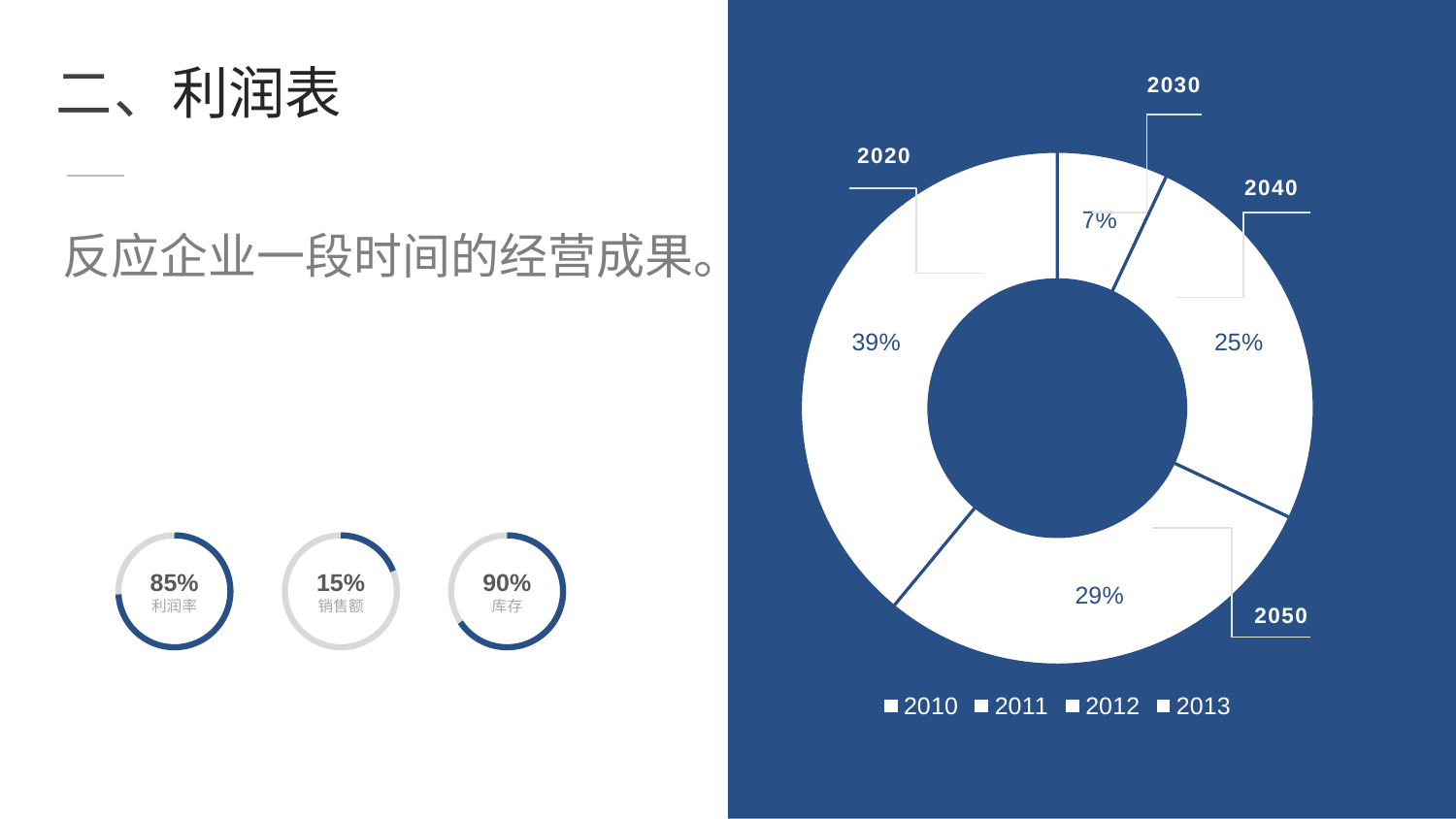
What is the title of the slide containing the doughnut chart? 二、利润表 What is the smallest percentage shown on the doughnut chart? 7% What are the four percentage labels shown on the doughnut chart? 7%, 25%, 29%, 39% How many slices does the doughnut chart have? 4 What are the legend entries of the doughnut chart? 2010, 2011, 2012, 2013 Which is larger in the doughnut chart, the 25% slice or the 29% slice? The 29% slice How many series does the legend of the doughnut chart list? 4 What is the largest percentage shown on the doughnut chart? 39% What kind of chart is shown on the right side of the slide? Doughnut (pie) chart Is the largest slice of the doughnut chart greater or less than 30%? greater What do the four percentages on the doughnut chart add up to? 100% What is the difference between the largest slice (39%) and the smallest slice (7%) in the doughnut chart? 32 percentage points